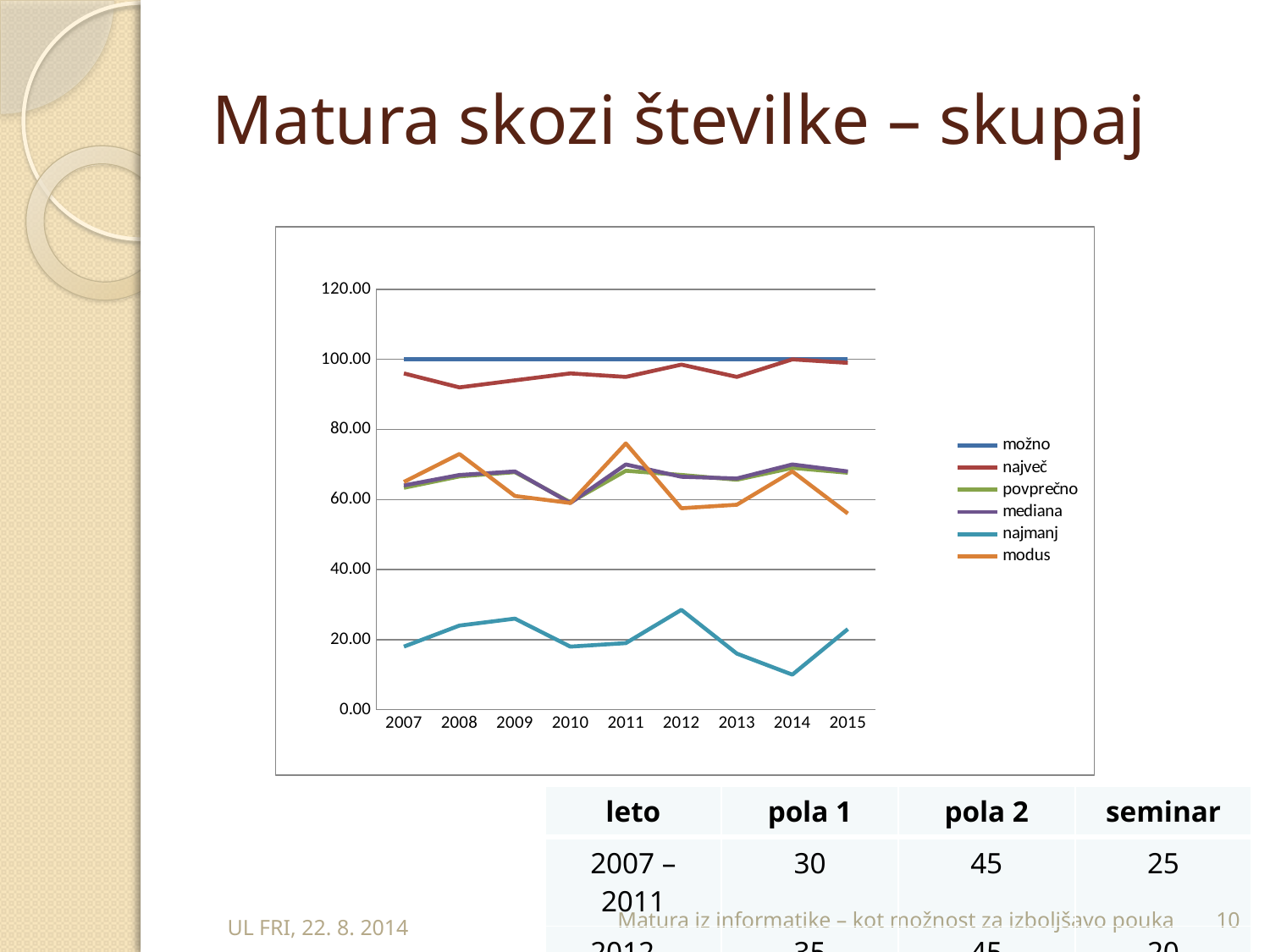
How many series does the chart's legend list? 6 In which year does the 'najmanj' series reach its lowest value? 2014 What kind of chart is shown on the slide? line chart How many years are plotted along the x axis of the chart? 9 Is the value of 'največ' in 2008 greater or less than 80.00? greater Is the value of 'najmanj' in 2012 greater or less than 20.00? greater Does the 'najmanj' series rise or fall from 2012 to 2014? fall What is the value of the 'možno' series in 2010? 100.00 Is the value of 'najmanj' in 2014 greater or less than 20.00? less Which series is drawn as the flat blue line at the top of the chart? možno Which is larger for the 'najmanj' series: the value in 2012 or the value in 2014? 2012